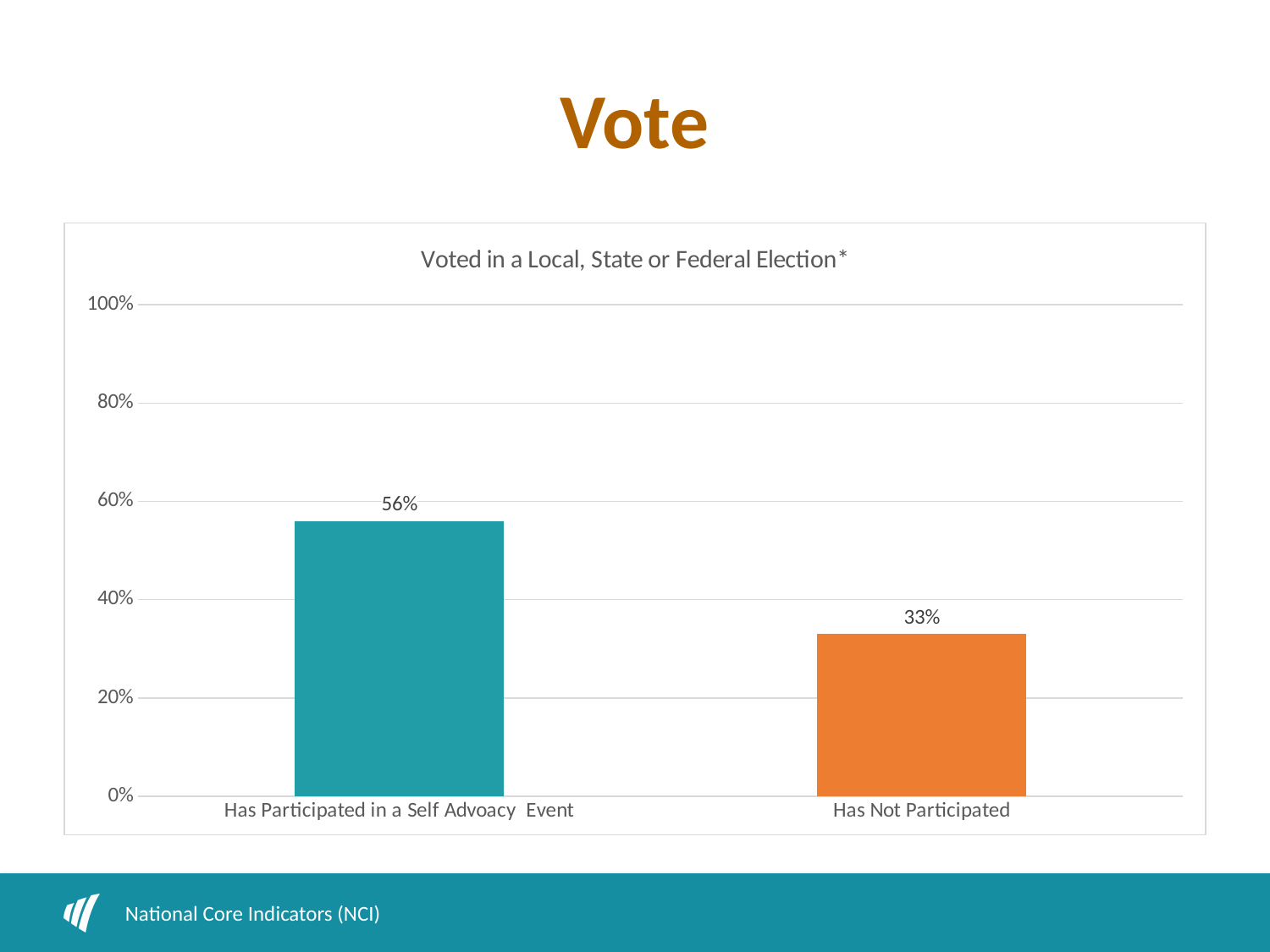
Which category has the lower percentage of voting? Has Not Participated Is the value for 'Has Participated in a Self Advoacy Event' greater or less than 60%? less What is the maximum value shown on the y axis? 100% Is the value for 'Has Participated in a Self Advoacy Event' larger or smaller than the value for 'Has Not Participated'? larger Which category has the higher percentage of voting? Has Participated in a Self Advoacy Event How many categories are shown on the chart? 2 What percentage of people who have not participated voted in a local, state or federal election? 33% What percentage of people who have participated in a self advocacy event voted in a local, state or federal election? 56% Is the value for 'Has Not Participated' greater or less than 40%? less What kind of chart is shown on the slide? bar chart What is the difference in percentage points between the two categories? 23 What is the title of the chart? Voted in a Local, State or Federal Election*